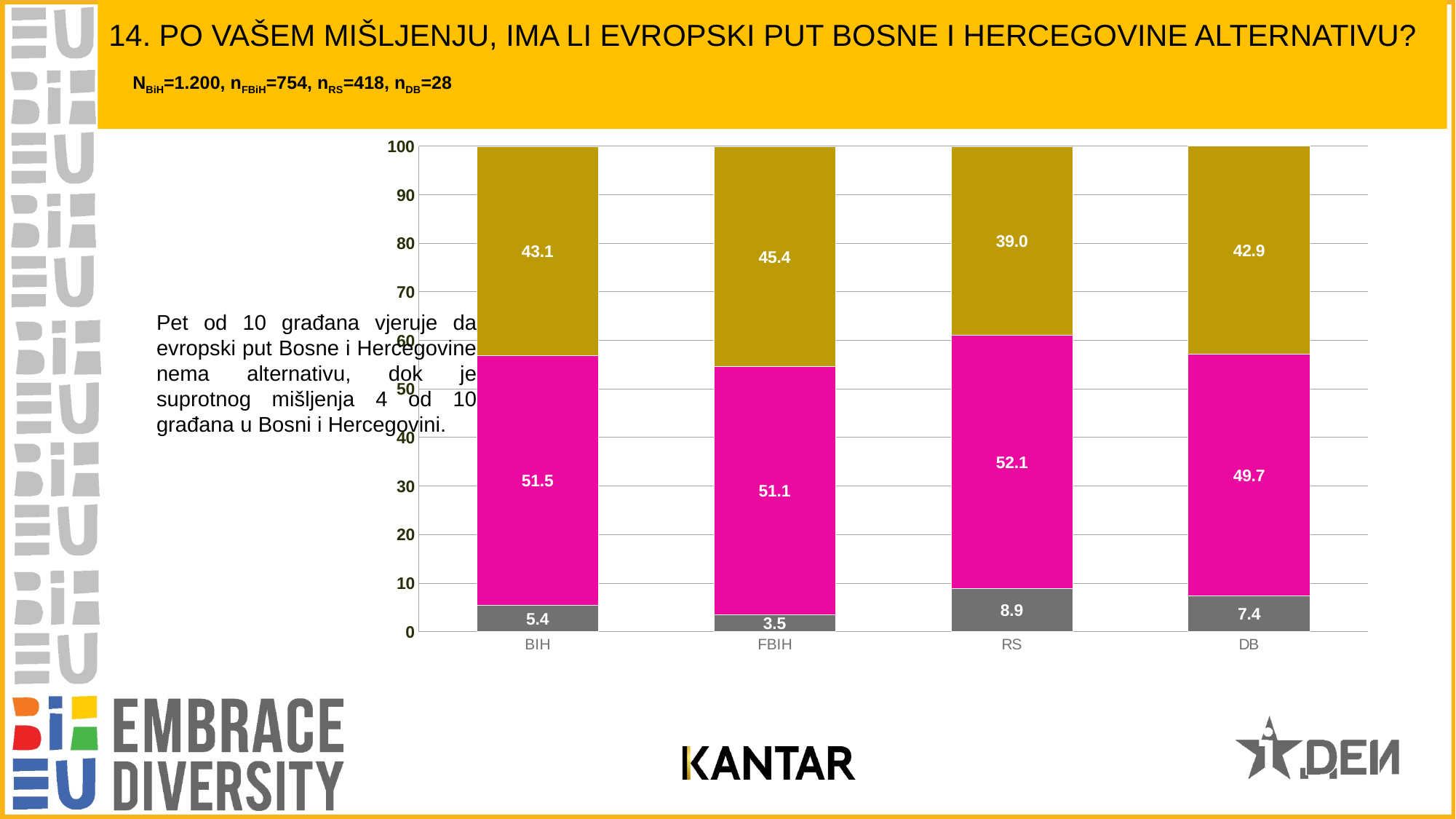
What kind of chart is shown on the slide? Stacked bar chart What is the value of the gold (top) segment for BIH? 43.1 Is the magenta (middle) segment value larger for RS or for DB? RS What is the difference between the gold (top) segment values for FBIH and RS? 6.4 What is the value of the magenta (middle) segment for FBIH? 51.1 Which category has the highest value for the grey (bottom) segment? RS How many categories are shown on the x axis of the chart? 4 Which category has the lowest value for the gold (top) segment? RS Which category has the lowest value for the grey (bottom) segment? FBIH What is the value of the grey (bottom) segment for RS? 8.9 What is the value of the gold (top) segment for DB? 42.9 What is the total of the stacked bar for BIH? 100